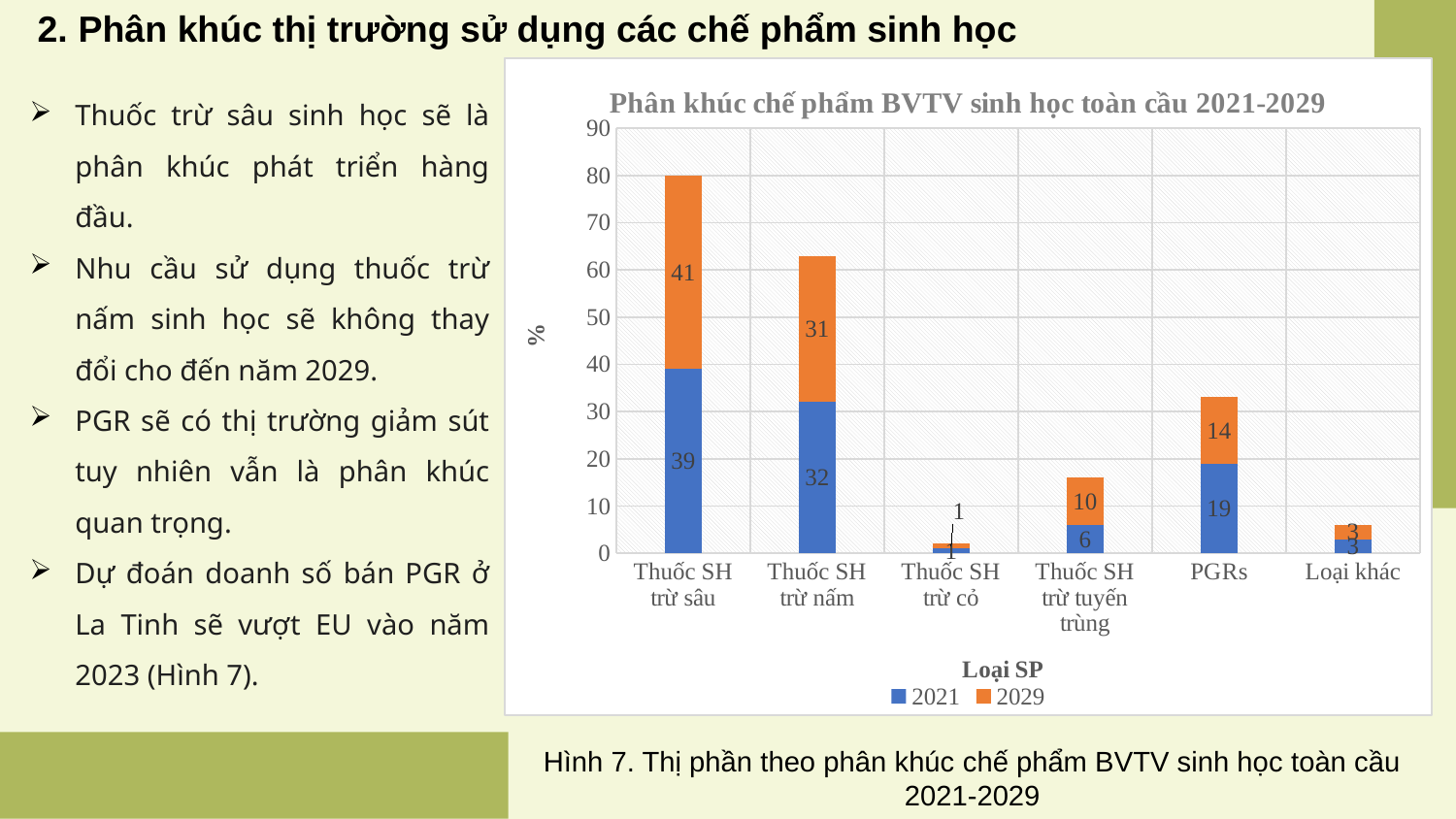
How many series does the legend list? 2 What is the difference between the 2029 and 2021 values for Thuốc SH trừ tuyến trùng? 4 Which category has the lowest 2029 value? Thuốc SH trừ cỏ Which category has the highest 2021 value? Thuốc SH trừ sâu What is the 2021 value for Thuốc SH trừ sâu? 39 How many categories are shown on the x axis? 6 What kind of chart is shown? Stacked bar chart What is the total of the stacked bar for Thuốc SH trừ sâu? 80 What is the 2029 value for Thuốc SH trừ nấm? 31 What is the 2021 value for Thuốc SH trừ tuyến trùng? 6 What is the 2029 value for PGRs? 14 Which is larger for PGRs: the 2021 value or the 2029 value? 2021